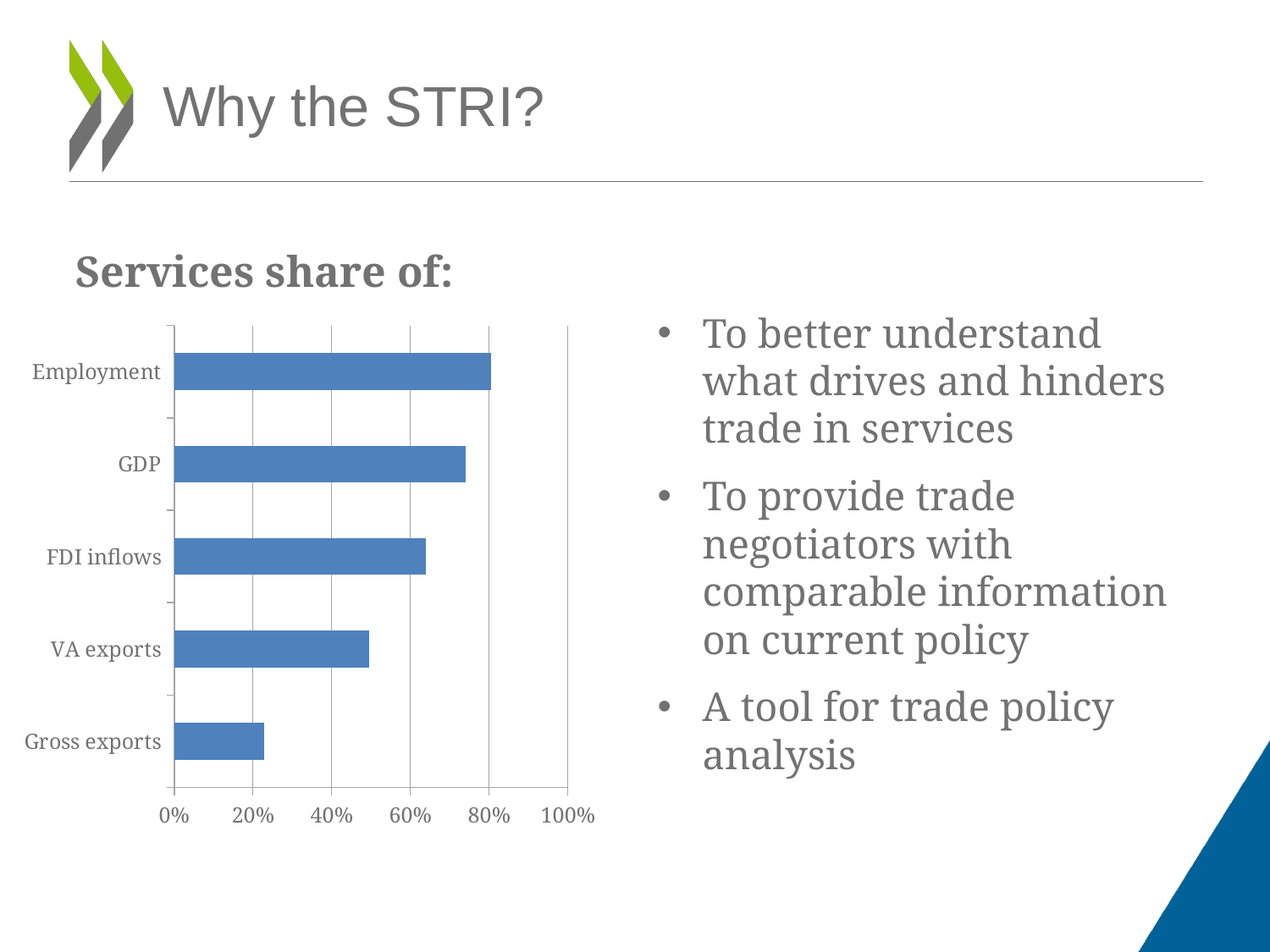
Which category has the lowest services share? Gross exports Which is larger, the services share of GDP or of FDI inflows? GDP Is the value for Gross exports greater or less than 40%? less What is the title of the chart? Services share of: Is the value for FDI inflows greater or less than 40%? greater Which is larger, the services share of VA exports or of Gross exports? VA exports What kind of chart is shown on the slide? bar chart Which category has the highest services share? Employment Is the value for Employment greater or less than 60%? greater How many categories are plotted in the chart? 5